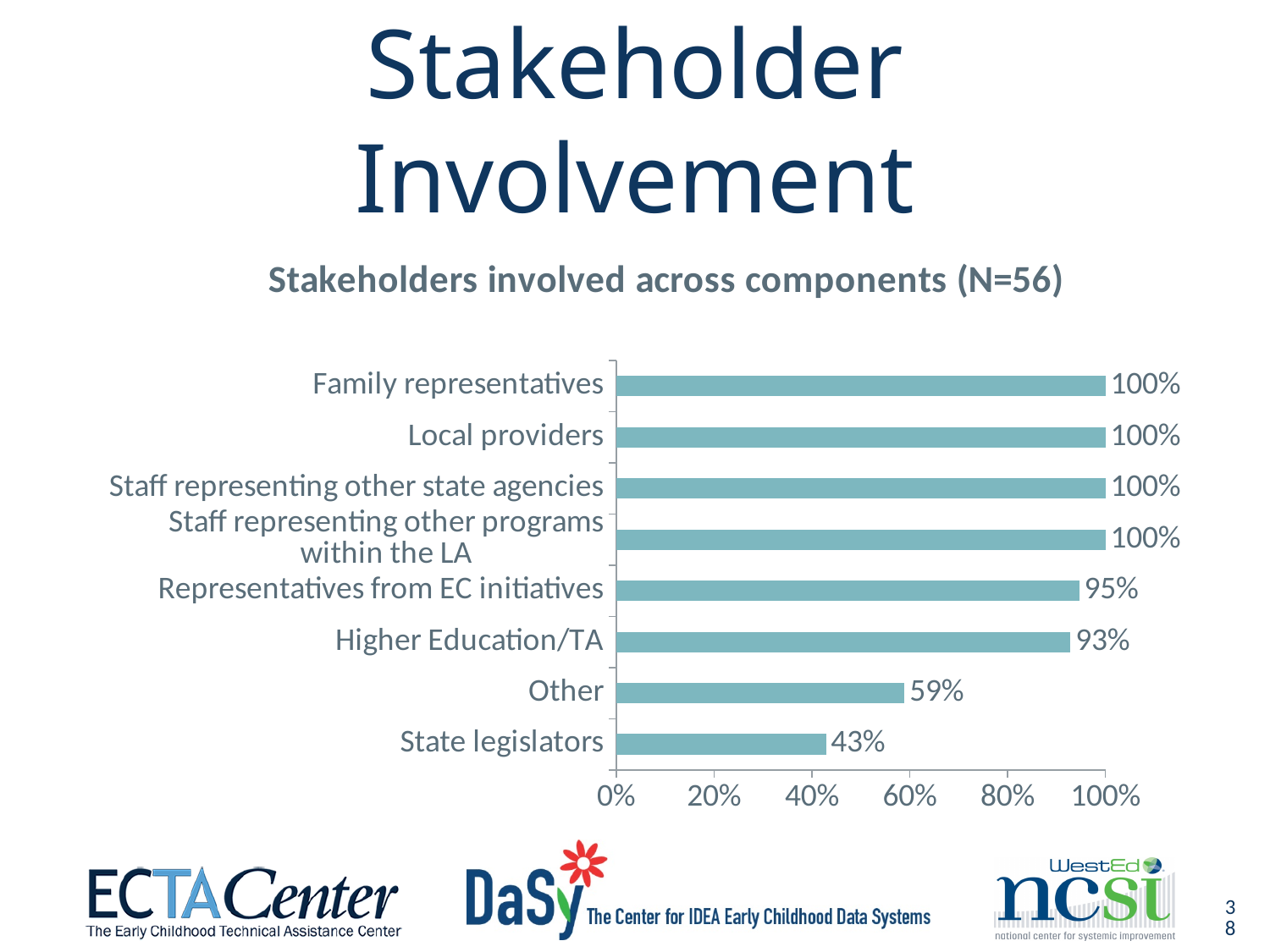
What is the value for Higher Education/TA? 93% What kind of chart is shown on the slide? bar chart How many categories are shown in the chart? 8 Which is larger, the value for Representatives from EC initiatives or the value for Other? Representatives from EC initiatives What is the value for State legislators? 43% What is the value for Other? 59% What is the difference between the values for Other and State legislators? 16% What is the value for Representatives from EC initiatives? 95% What is the difference between the values for Family representatives and Higher Education/TA? 7% Which category has the lowest value? State legislators Is the value for Other greater or less than 40%? greater What is the title of the chart? Stakeholders involved across components (N=56)